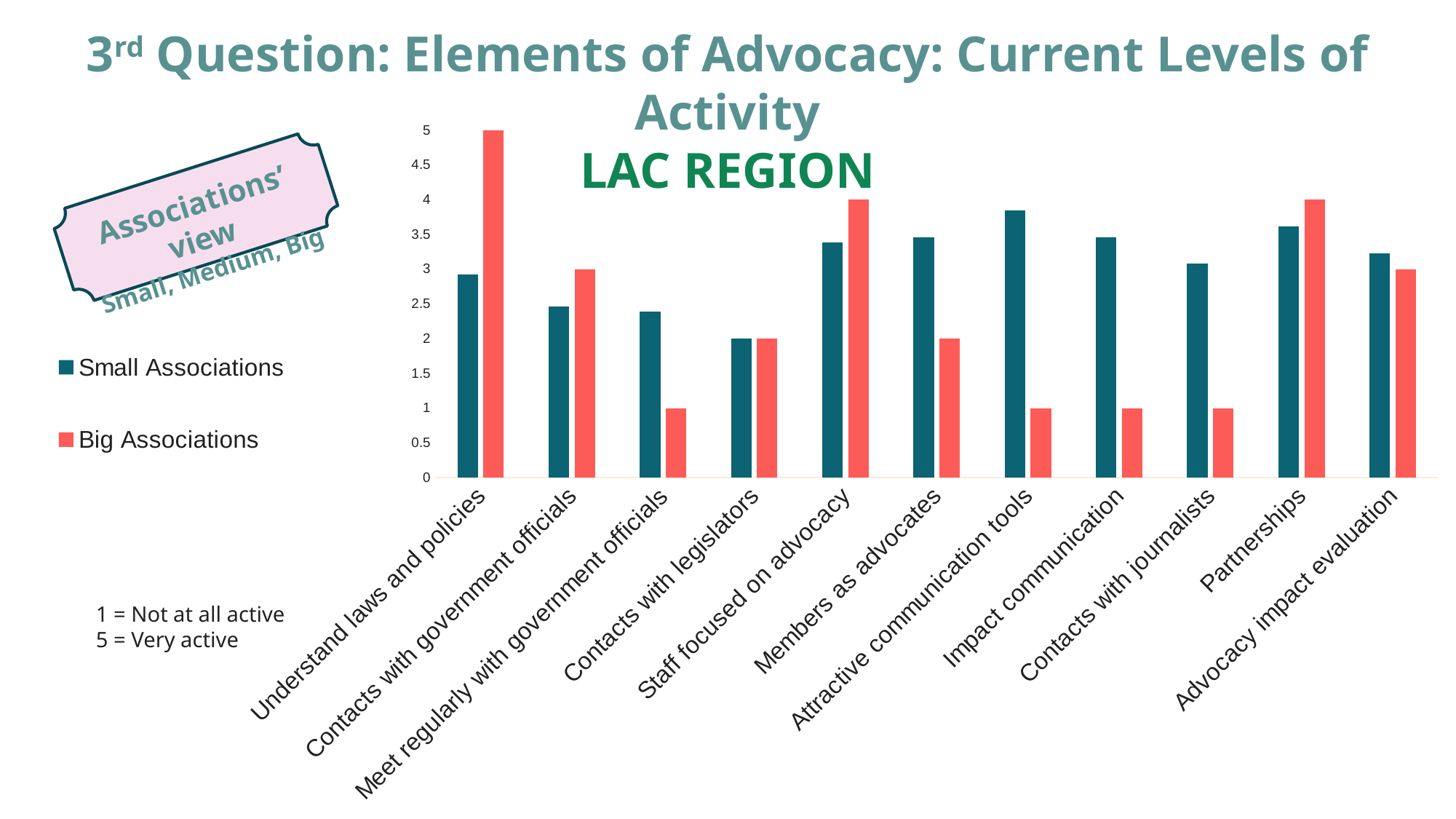
What is the value for Big Associations for 'Partnerships'? 4 What is the difference between the Big Associations values for 'Understand laws and policies' and 'Meet regularly with government officials'? 4 Is the value for Small Associations for 'Attractive communication tools' greater or less than 3.5? greater How many series does the legend list? 2 What kind of chart is shown on the slide? Bar chart What is the value for Big Associations for 'Understand laws and policies'? 5 What is the value for Big Associations for 'Staff focused on advocacy'? 4 How many categories are shown along the x axis? 11 Which category has the highest value for Big Associations? Understand laws and policies For 'Attractive communication tools', which series has the larger value, Small Associations or Big Associations? Small Associations What colour represents Big Associations in the chart? Red